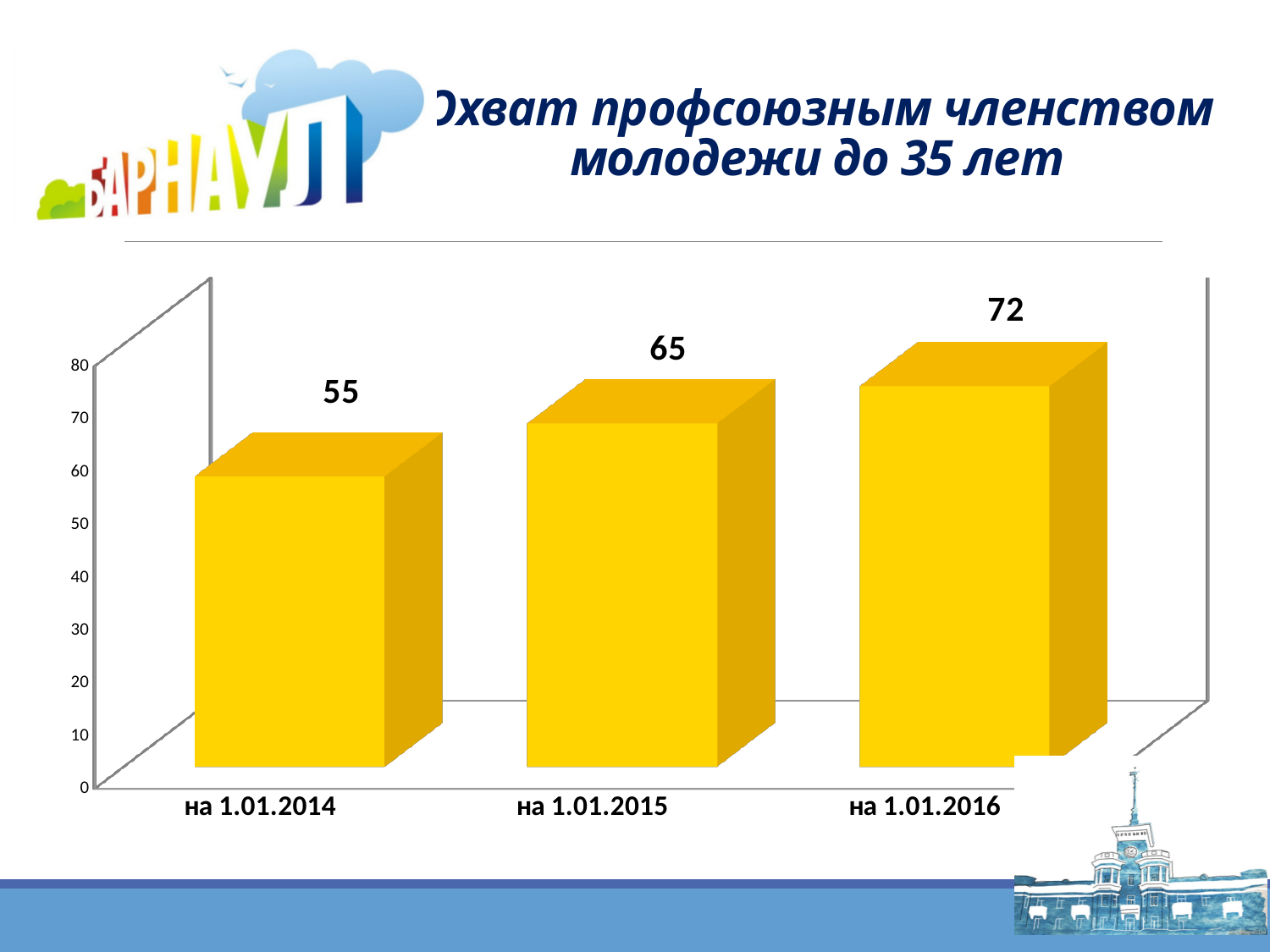
Which category has the highest value? на 1.01.2016 What is the title of the slide? Охват профсоюзным членством молодежи до 35 лет What is the value for на 1.01.2014? 55 What is the difference between the values for на 1.01.2015 and на 1.01.2014? 10 Do the values rise or fall from на 1.01.2014 to на 1.01.2016? rise What is the value for на 1.01.2015? 65 What is the difference between the values for на 1.01.2016 and на 1.01.2014? 17 What kind of chart is shown on the slide? bar chart How many categories are shown on the x axis? 3 What is the value for на 1.01.2016? 72 Which category has the lowest value? на 1.01.2014 Which is larger, the value for на 1.01.2015 or the value for на 1.01.2016? на 1.01.2016